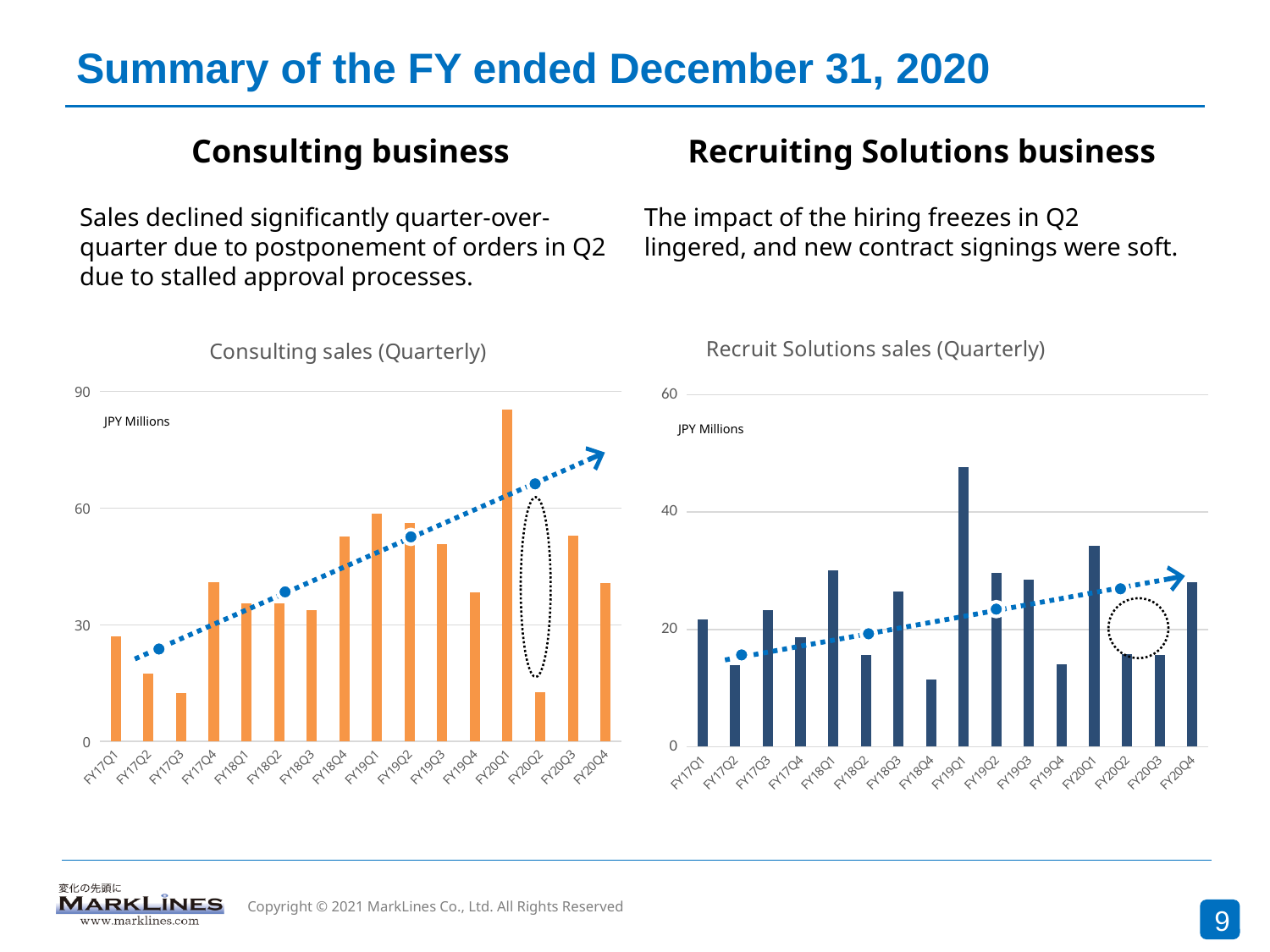
In the Recruit Solutions sales (Quarterly) chart, is the value for FY19Q1 greater or less than 40? greater In the Consulting sales (Quarterly) chart, which is larger, FY20Q1 or FY20Q2? FY20Q1 In the Consulting sales (Quarterly) chart, does the dotted trend line rise or fall from FY17 to FY20? rise In the Consulting sales (Quarterly) chart, is the value for FY17Q1 greater or less than 30? less In the Recruit Solutions sales (Quarterly) chart, which quarter has the highest sales? FY19Q1 How many quarters are plotted on the Consulting sales (Quarterly) chart? 16 In the Recruit Solutions sales (Quarterly) chart, which is larger, FY20Q1 or FY20Q2? FY20Q1 What unit is shown on the Recruit Solutions sales (Quarterly) chart? JPY Millions What type of chart is the Consulting sales (Quarterly) chart? bar chart In the Recruit Solutions sales (Quarterly) chart, is the value for FY18Q4 greater or less than 20? less In the Consulting sales (Quarterly) chart, which quarter has the highest sales? FY20Q1